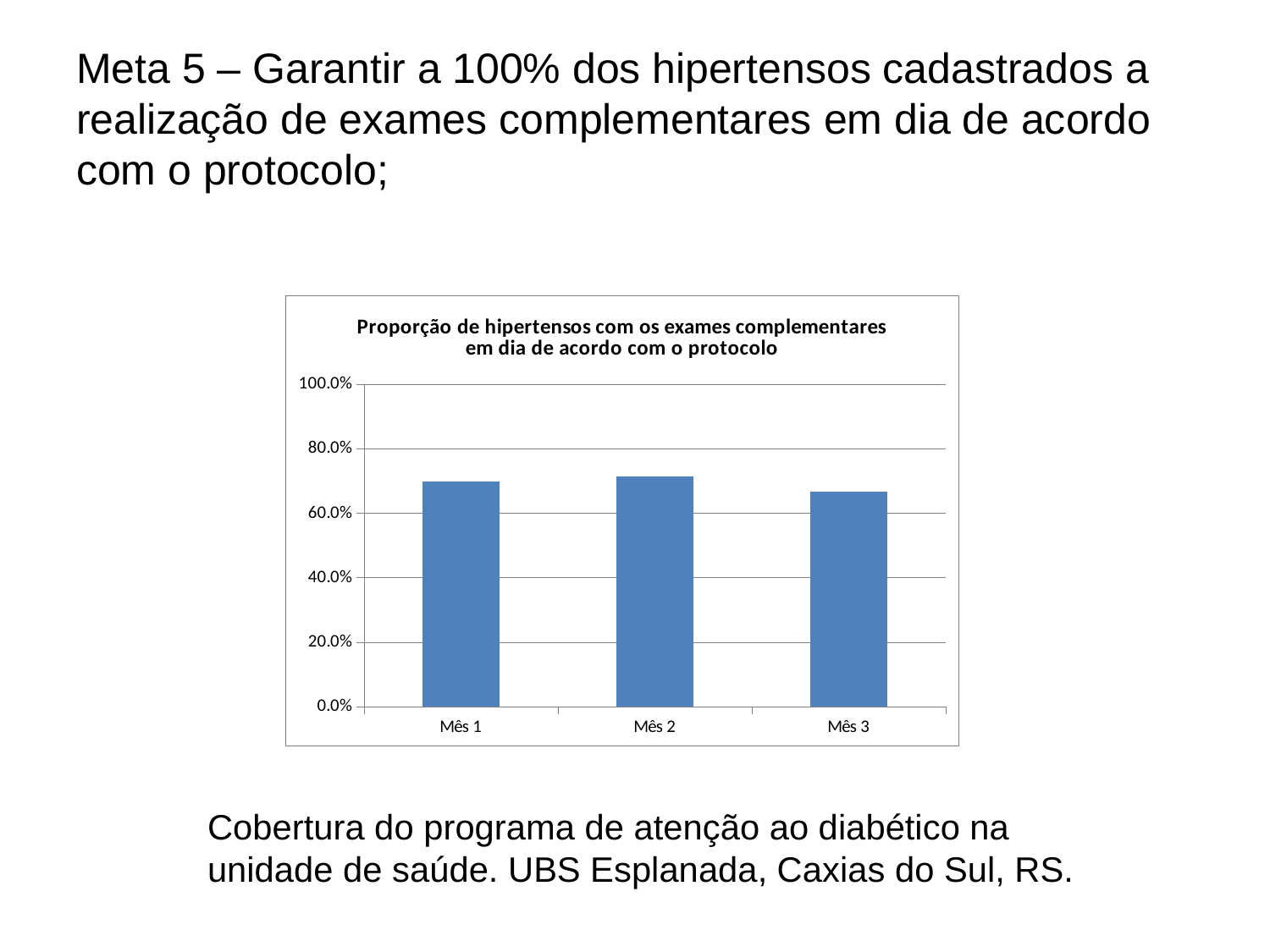
Does the value rise or fall from Mês 2 to Mês 3? fall Is the value for Mês 2 greater or less than 60.0%? greater What is the title of the chart? Proporção de hipertensos com os exames complementares em dia de acordo com o protocolo Is the value for Mês 1 greater or less than 60.0%? greater Which is larger, the value for Mês 2 or the value for Mês 3? Mês 2 How many categories (months) are plotted on the x axis of the chart? 3 What is the highest value shown on the vertical axis of the chart? 100.0% Is the value for Mês 2 greater or less than 80.0%? less Which month has the lowest value in the chart? Mês 3 What kind of chart is shown on the slide? bar chart